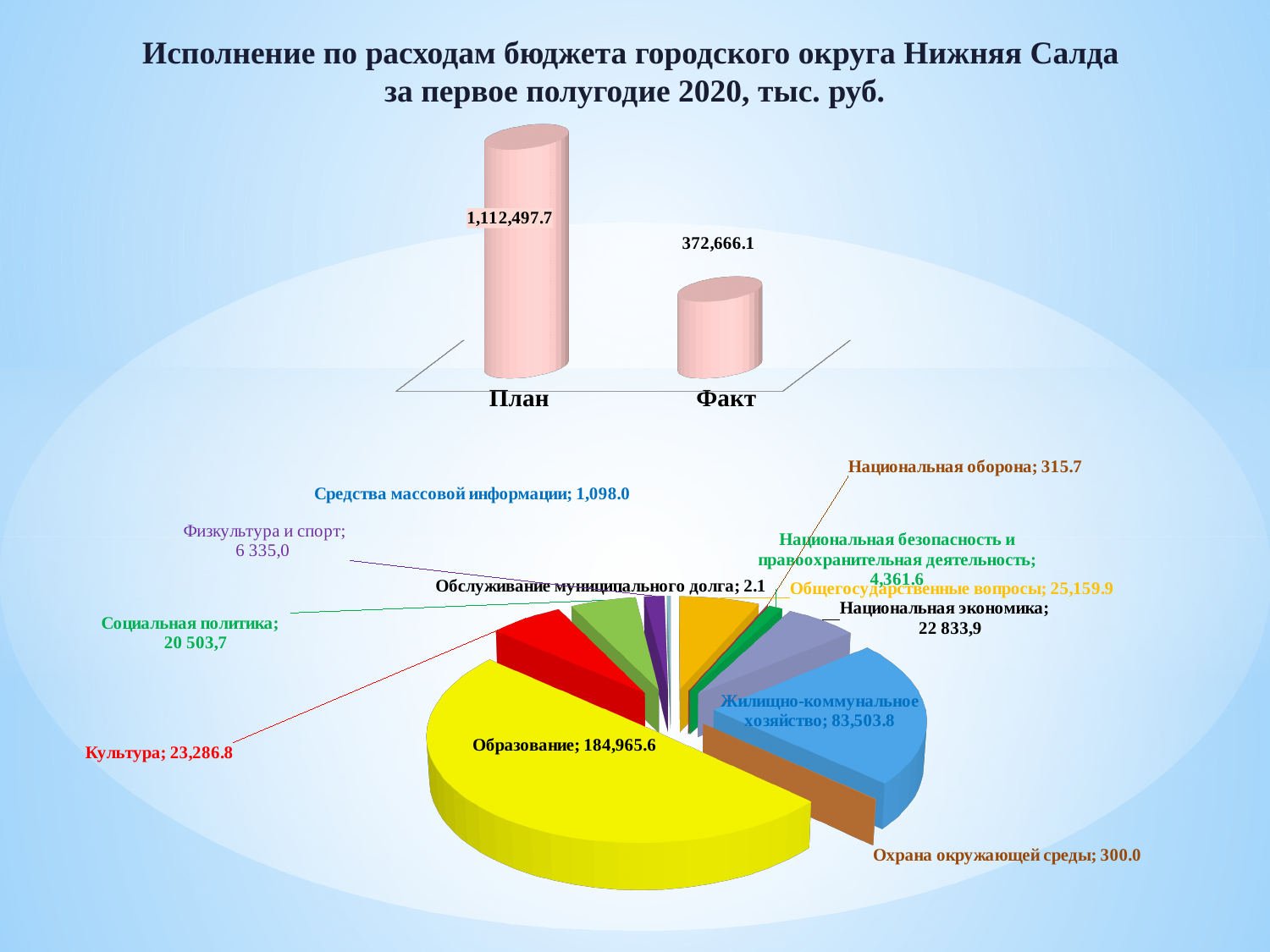
In the bar chart at the top, what is the difference between План and Факт? 739,831.6 In the pie chart at the bottom, what is the difference between Образование and Жилищно-коммунальное хозяйство? 101,461.8 In the pie chart at the bottom, which category has the smallest value? Обслуживание муниципального долга In the pie chart at the bottom, what is the value for Образование? 184,965.6 In the pie chart at the bottom, what is the value for Жилищно-коммунальное хозяйство? 83,503.8 In the pie chart at the bottom, which category has the largest value? Образование In the bar chart at the top, how many categories are shown? 2 In the bar chart at the top, what is the value for План? 1,112,497.7 What kind of chart is the top chart with План and Факт? Bar chart In the bar chart at the top, what is the value for Факт? 372,666.1 In the pie chart at the bottom, which is larger: Культура or Национальная экономика? Культура In the pie chart at the bottom, how many categories are shown? 12